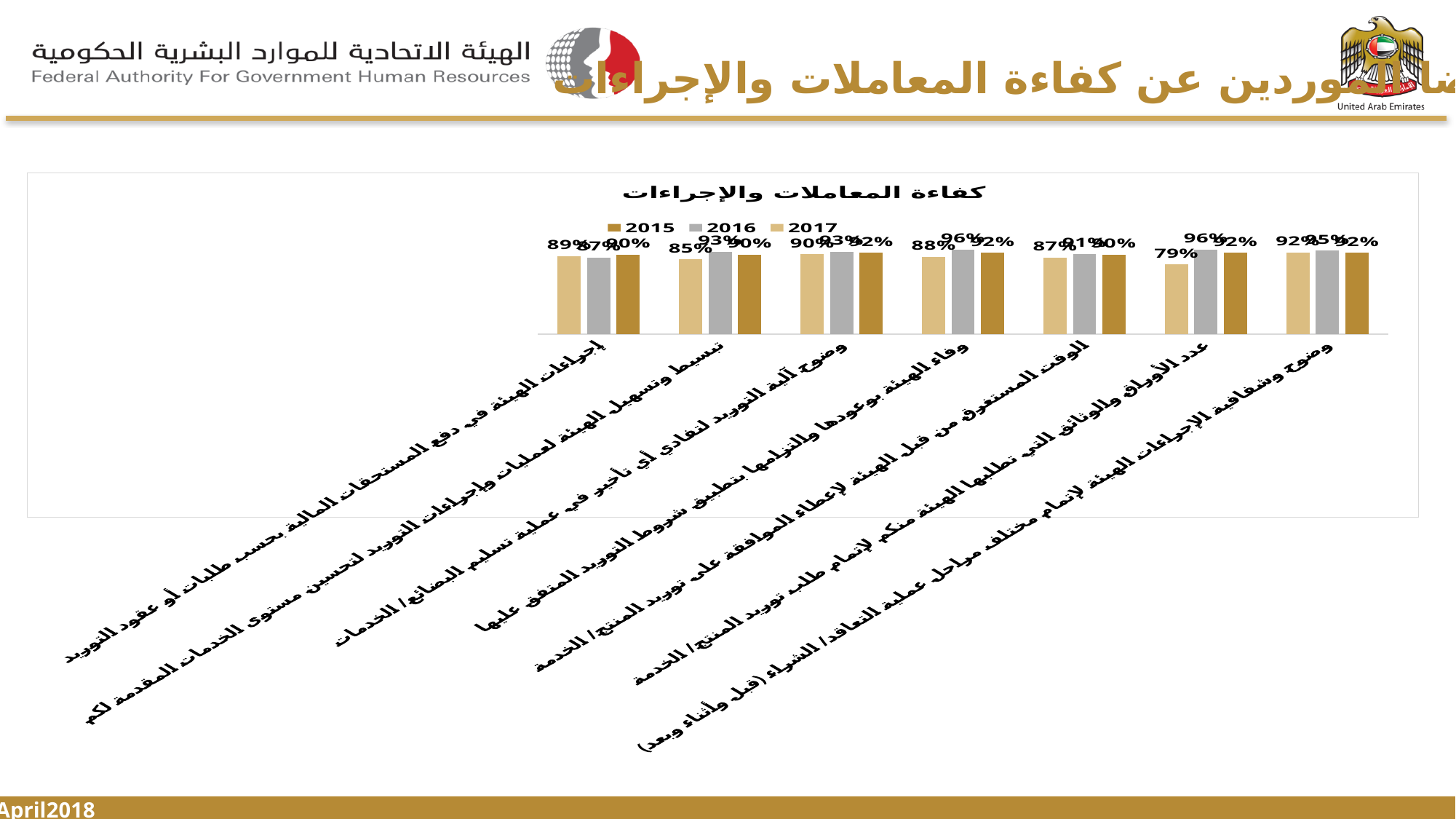
For the category 'عدد الأوراق والوثائق التي تطلبها الهيئة منكم لإتمام طلب توريد المنتج / الخدمة', what is the difference between the 2016 value and the 2017 value? 17 percentage points What kind of chart is shown on the slide? Bar chart What is the 2016 value for the category 'عدد الأوراق والوثائق التي تطلبها الهيئة منكم لإتمام طلب توريد المنتج / الخدمة'? 96% What is the 2017 value for the category 'عدد الأوراق والوثائق التي تطلبها الهيئة منكم لإتمام طلب توريد المنتج / الخدمة'? 79% What is the 2016 value for the category 'وفاء الهيئة بوعودها والتزامها بتطبيق شروط التوريد المتفق عليها'? 96% What is the title of the chart? كفاءة المعاملات والإجراءات Which years are listed in the chart legend? 2015, 2016, 2017 How many categories are plotted along the x axis of the chart? 7 For the category 'عدد الأوراق والوثائق التي تطلبها الهيئة منكم لإتمام طلب توريد المنتج / الخدمة', which is larger, the 2016 value or the 2017 value? 2016 What is the 2017 value for the category 'تبسيط وتسهيل الهيئة لعمليات وإجراءات التوريد لتحسين مستوى الخدمات المقدمة لكم'? 85% What is the lowest value shown on the chart? 79% How many series does the chart legend list? 3